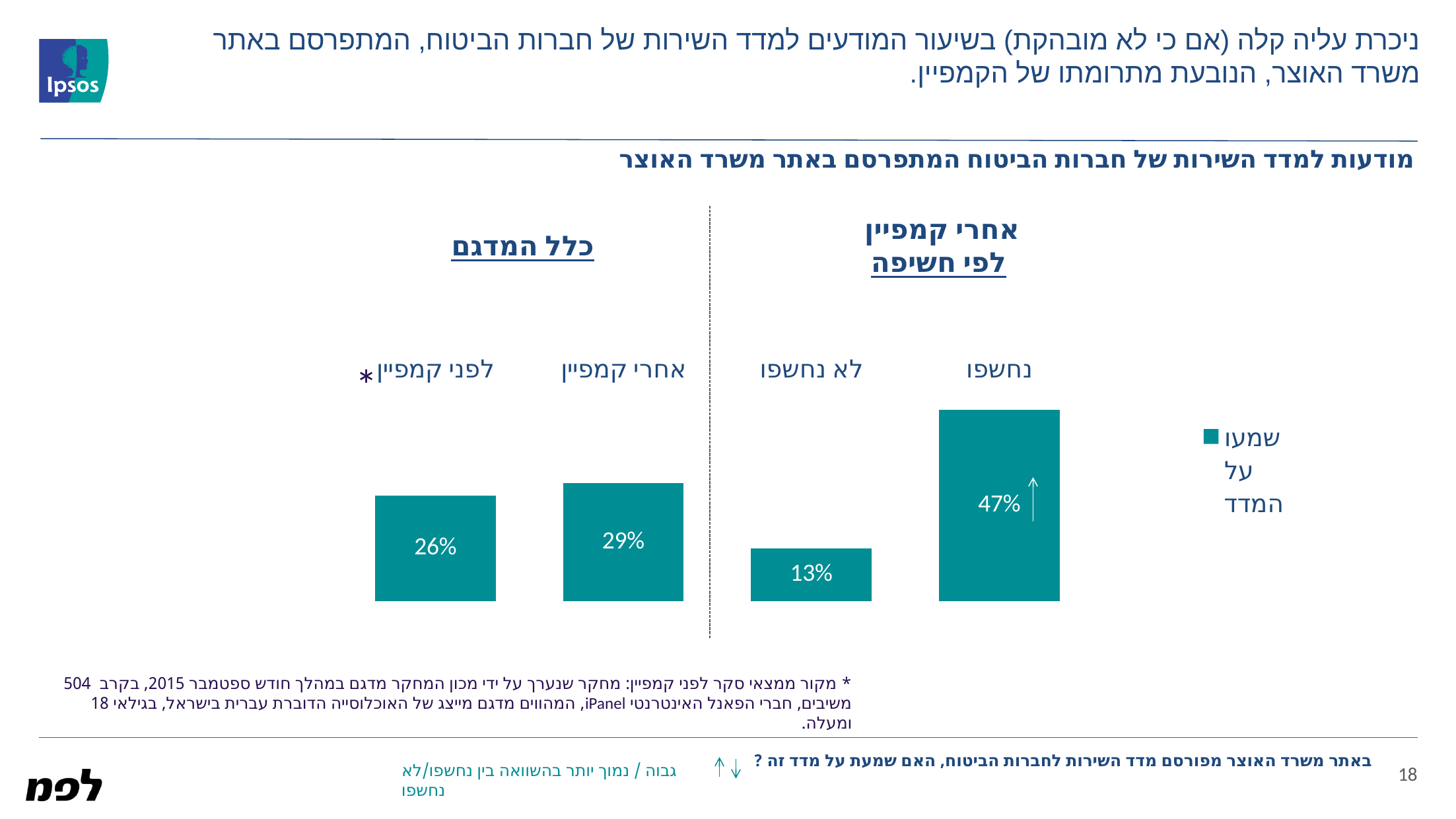
In the chart titled "כלל המדגם", which category has the lowest value? לפני קמפיין How many bars are shown in the chart titled "כלל המדגם"? 2 What kind of chart is used on the slide? Bar chart In the chart titled "אחרי קמפיין לפי חשיפה", what is the difference between the values for "נחשפו" and "לא נחשפו"? 34% In the chart titled "כלל המדגם", what is the difference between the values for "אחרי קמפיין" and "לפני קמפיין"? 3% In the chart titled "אחרי קמפיין לפי חשיפה", what is the value for "נחשפו"? 47% In the chart titled "אחרי קמפיין לפי חשיפה", which is larger: the value for "נחשפו" or for "לא נחשפו"? נחשפו What is the legend entry shown next to the chart titled "אחרי קמפיין לפי חשיפה"? שמעו על המדד In the chart titled "אחרי קמפיין לפי חשיפה", what is the value for "לא נחשפו"? 13% In the chart titled "כלל המדגם", what is the value for "לפני קמפיין"? 26% In the chart titled "כלל המדגם", what is the value for "אחרי קמפיין"? 29% In the chart titled "אחרי קמפיין לפי חשיפה", which category has the highest value? נחשפו